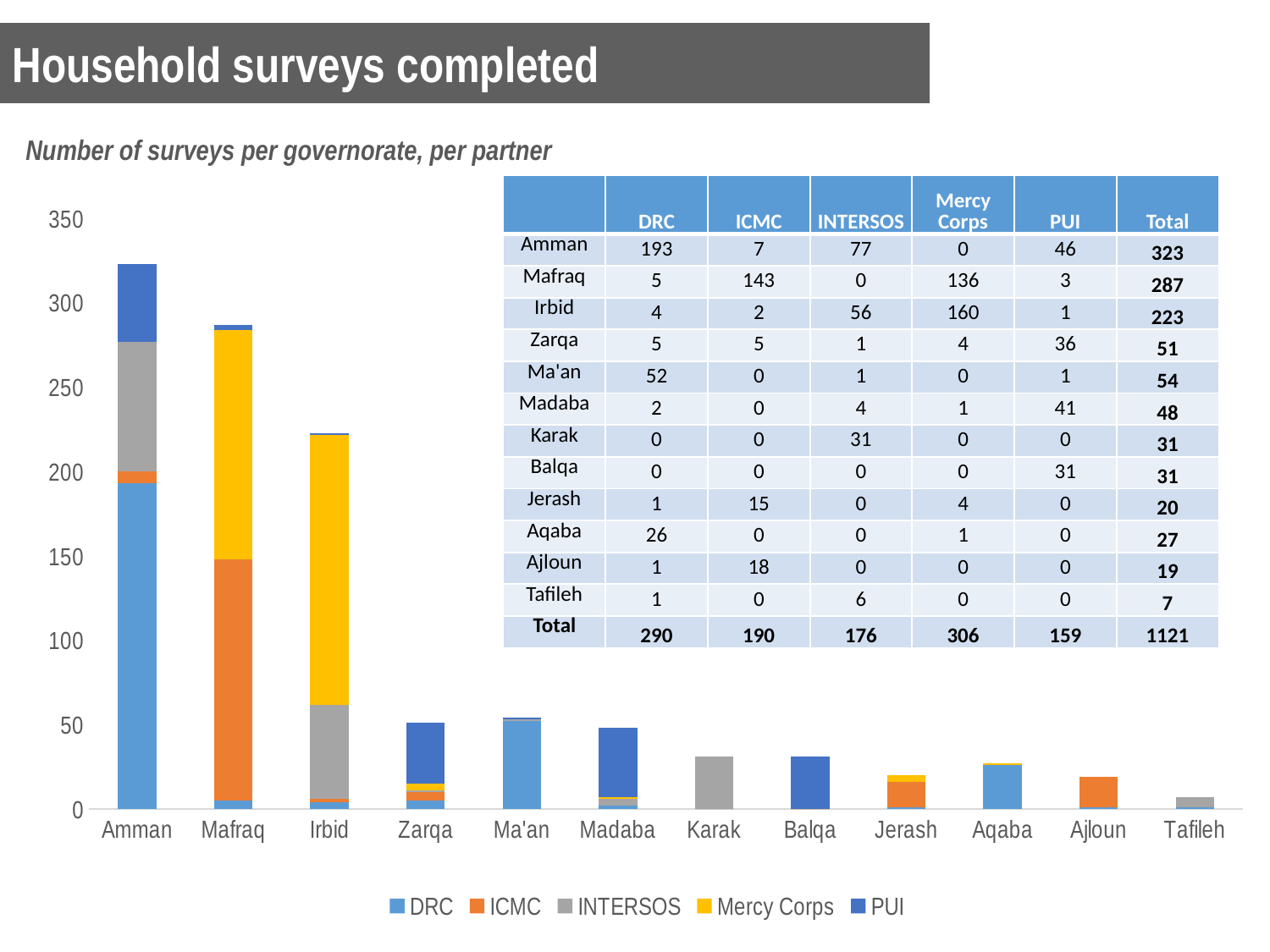
Which governorate has the lowest total number of surveys? Tafileh How many governorates are shown on the x axis of the chart? 12 Is the total value for Karak greater or less than 50? less How many series does the chart legend list? 5 What is the difference between the total surveys for Amman and Irbid? 100 How many surveys did Mercy Corps complete in Irbid? 160 What kind of chart is shown on the slide? Stacked bar chart How many surveys did DRC complete in Amman? 193 Which governorate has the highest total number of surveys? Amman Which partner is represented by the yellow colour in the chart legend? Mercy Corps What is the total number of surveys for Mafraq? 287 Which has a larger total of surveys, Zarqa or Ma'an? Ma'an